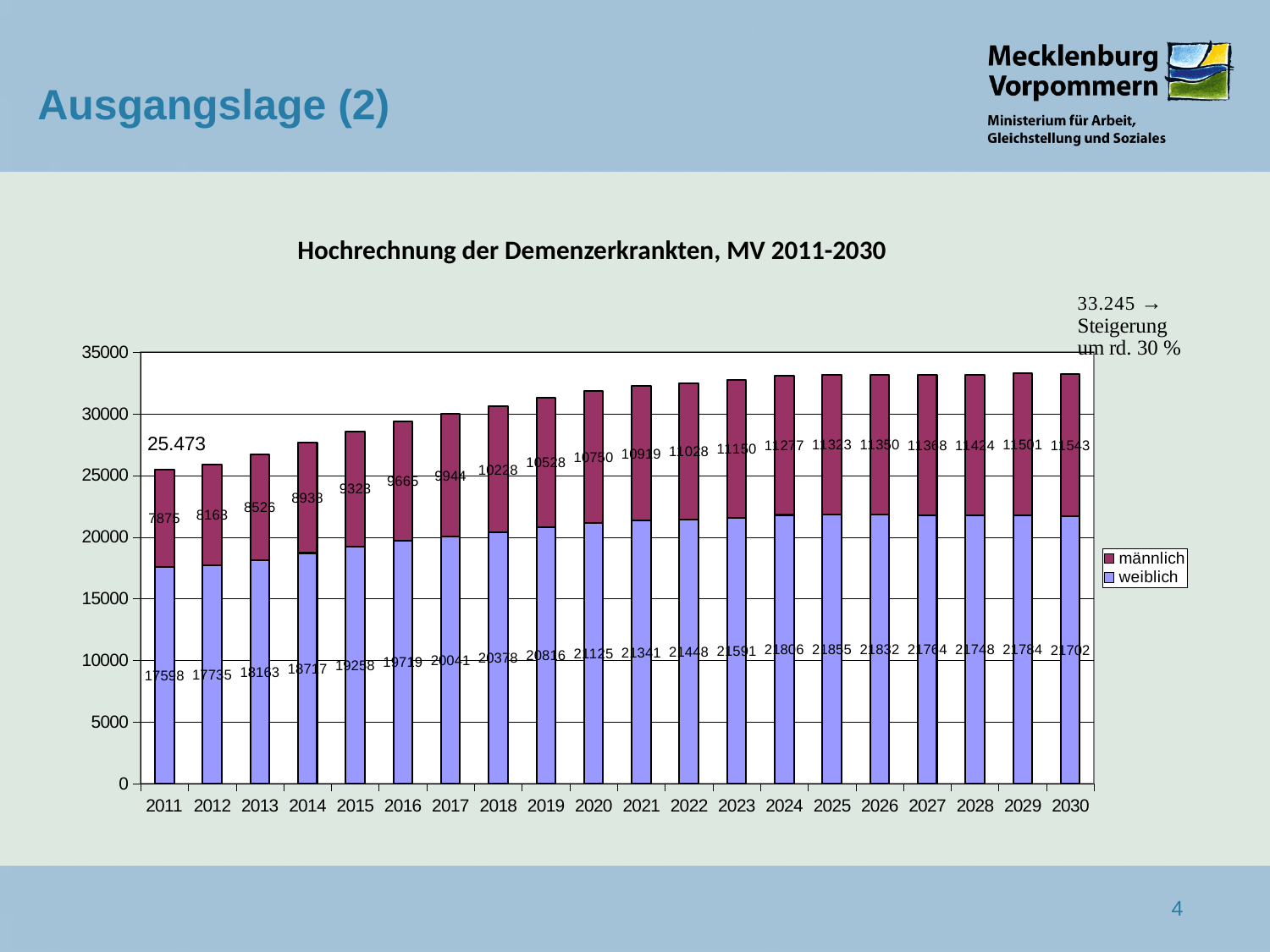
Which year has the highest weiblich value? 2025 Do the männlich values rise or fall from 2011 to 2030? rise What is the value for weiblich in 2011? 17598 What is the title of the chart? Hochrechnung der Demenzerkrankten, MV 2011-2030 What is the value for weiblich in 2025? 21855 How many series does the legend list? 2 How many years are shown on the x axis? 20 What is the total of the stacked bar for 2030? 33.245 What is the value for männlich in 2030? 11543 What type of chart is shown on the slide? stacked bar chart What is the difference between the männlich values for 2030 and 2011? 3668 What is the total of the stacked bar for 2011? 25.473